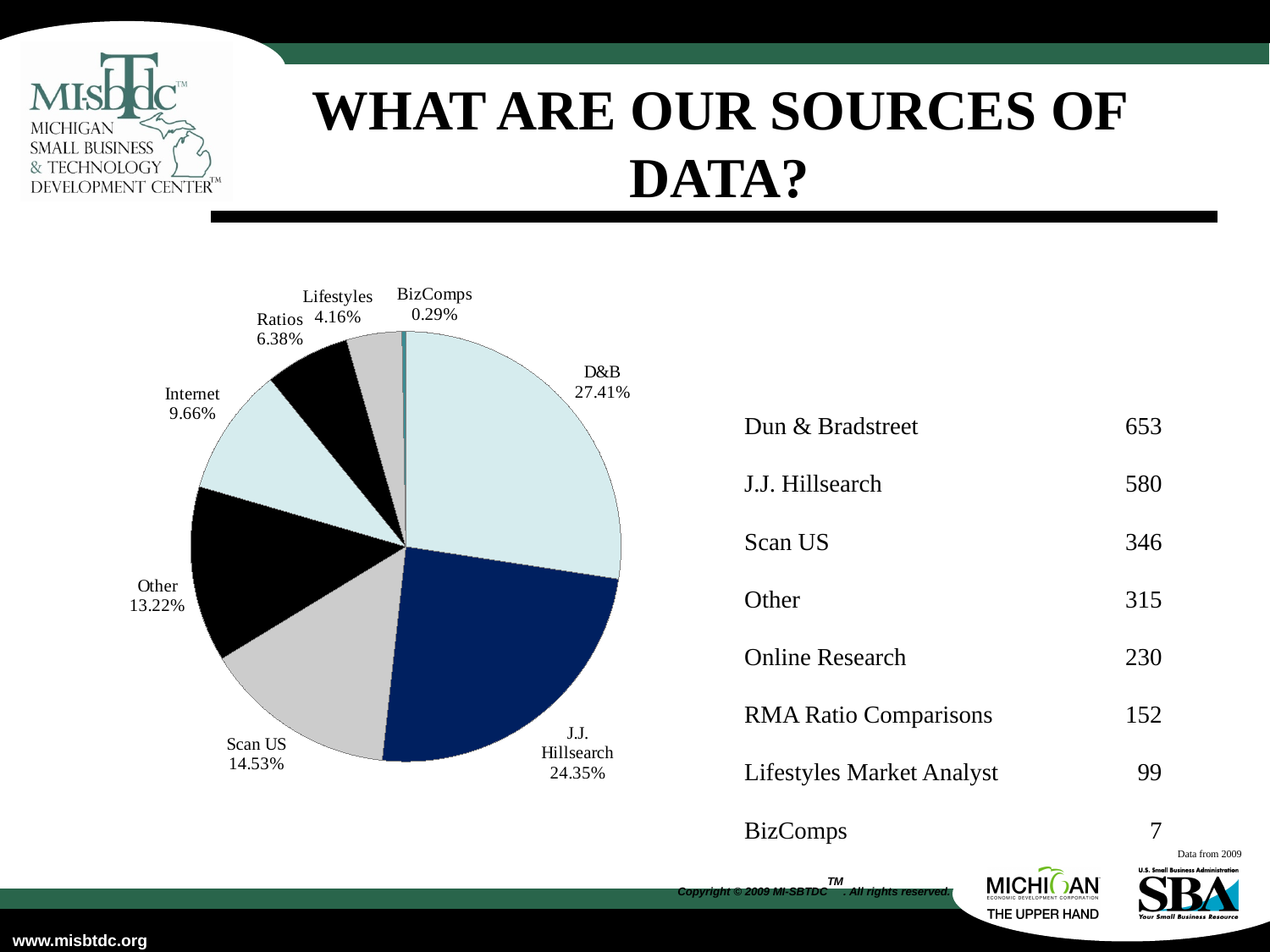
What is the value shown for Internet in the pie chart? 9.66% Which slice of the pie chart is the largest? D&B What is the difference in percentage points between D&B and J.J. Hillsearch? 3.06 Which slice of the pie chart is the smallest? BizComps How many slices does the pie chart have? 8 What share of the pie does J.J. Hillsearch hold? 24.35% What is the value shown for Scan US in the pie chart? 14.53% What share of the pie does D&B hold? 27.41% What is the value shown for Other in the pie chart? 13.22% What is the difference in percentage points between Ratios and Lifestyles? 2.22 Which is larger in the pie chart, Other or Scan US? Scan US What kind of chart is shown on the slide? pie chart